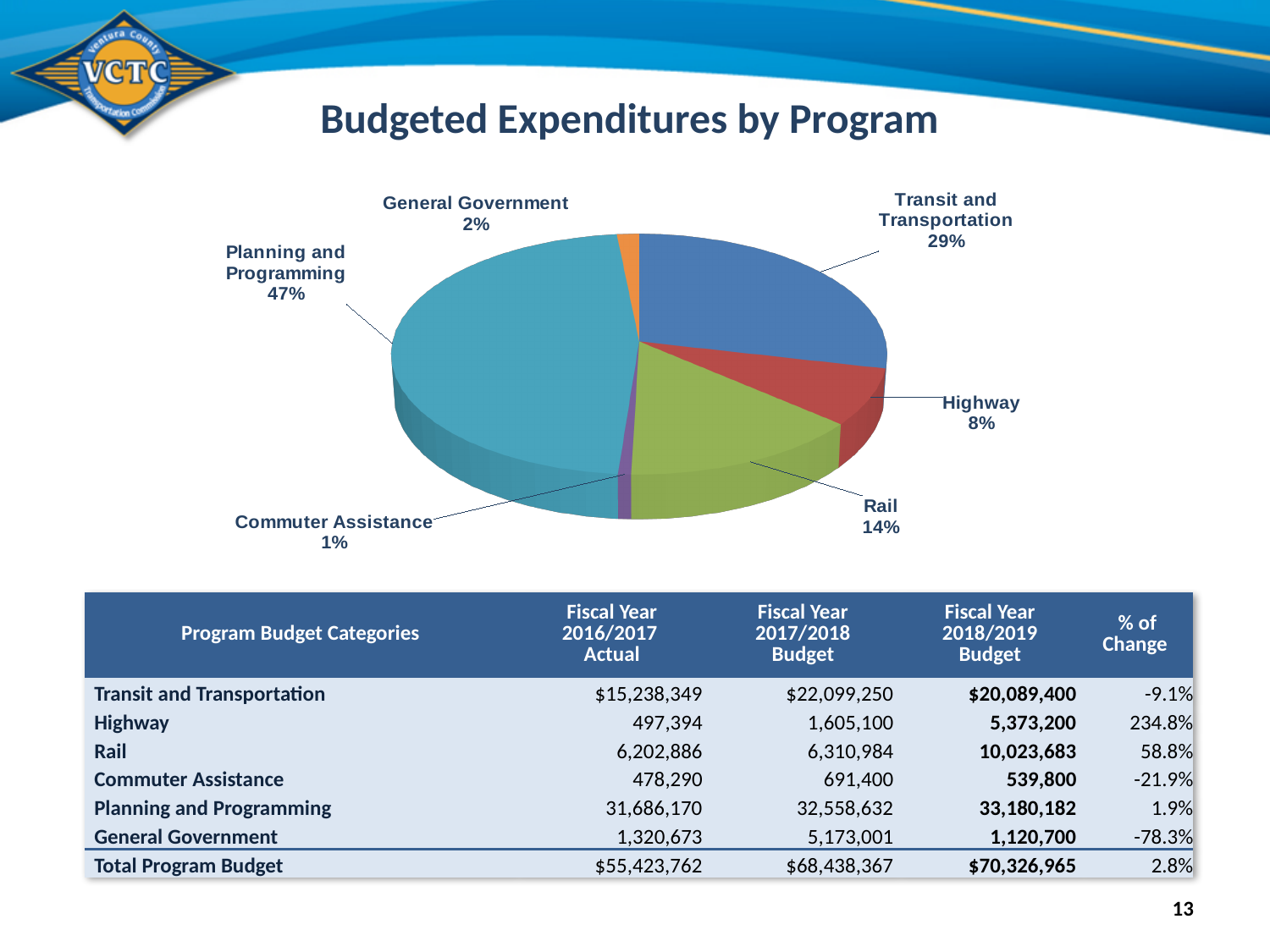
What share of the pie does Transit and Transportation represent? 29% What share of the pie does Planning and Programming represent? 47% What percentage is shown for Highway in the pie chart? 8% How many slices does the pie chart have? 6 What percentage is shown for Commuter Assistance in the pie chart? 1% Which slice is larger, Rail or Highway? Rail What type of chart is shown on the slide? pie chart What percentage is shown for Rail in the pie chart? 14% What is the title of the slide containing the pie chart? Budgeted Expenditures by Program What is the difference in percentage points between the Planning and Programming slice and the Transit and Transportation slice? 18 Which program has the smallest slice of the pie chart? Commuter Assistance Which program has the largest slice of the pie chart? Planning and Programming